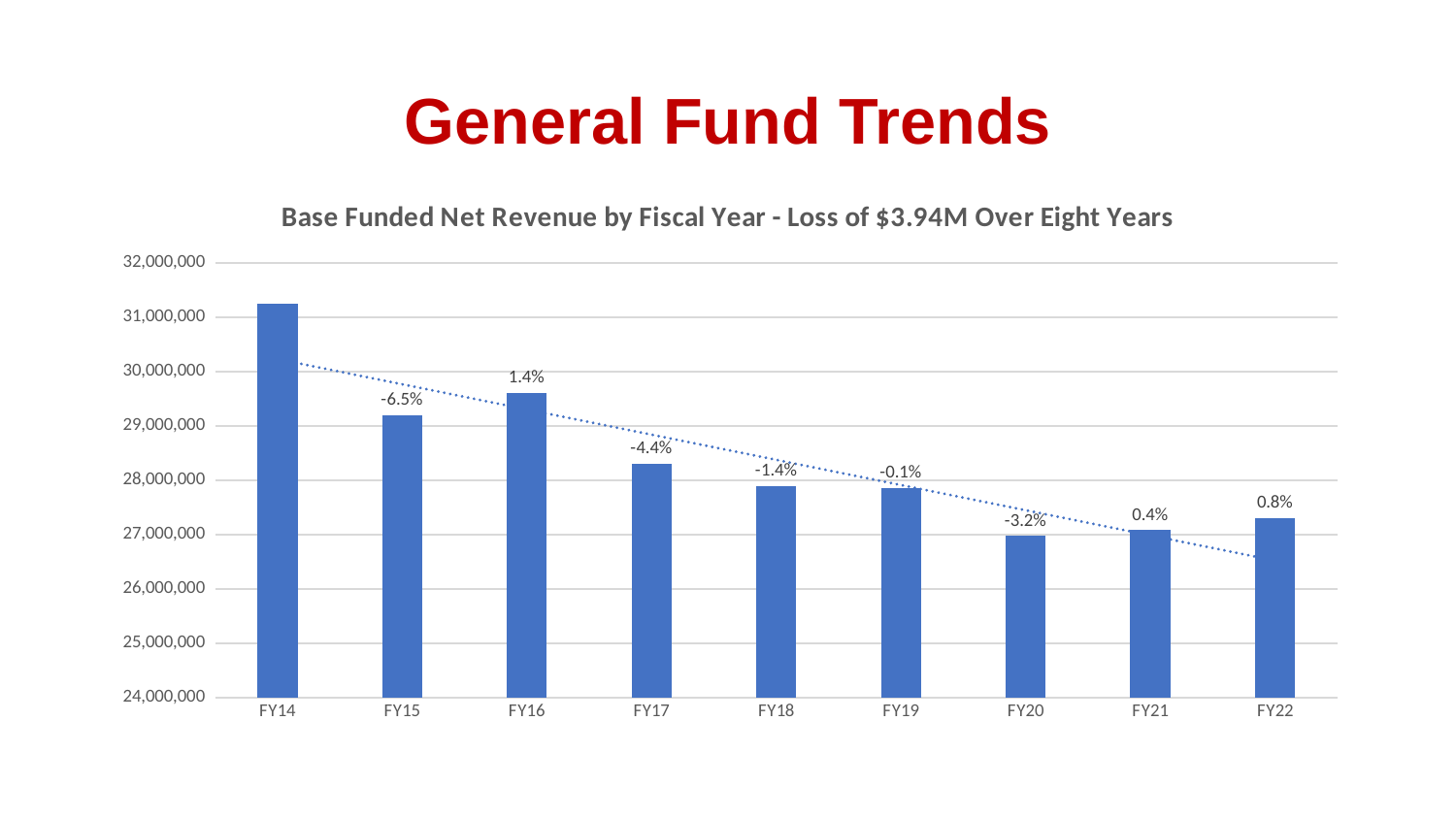
What percentage change is labeled for FY20? -3.2% Do the values generally rise or fall from FY14 to FY22? Fall What percentage change is labeled for FY16? 1.4% Which is larger, the value for FY17 or the value for FY18? FY17 What kind of chart is shown on the slide? Bar chart Which fiscal year has the highest base funded net revenue? FY14 What percentage change is labeled for FY22? 0.8% How many fiscal years are plotted on the chart? 9 Is the value for FY16 greater or less than 30,000,000? less What is the title of the chart? Base Funded Net Revenue by Fiscal Year - Loss of $3.94M Over Eight Years Is the value for FY14 greater or less than 31,000,000? greater What percentage change is labeled for FY15? -6.5%